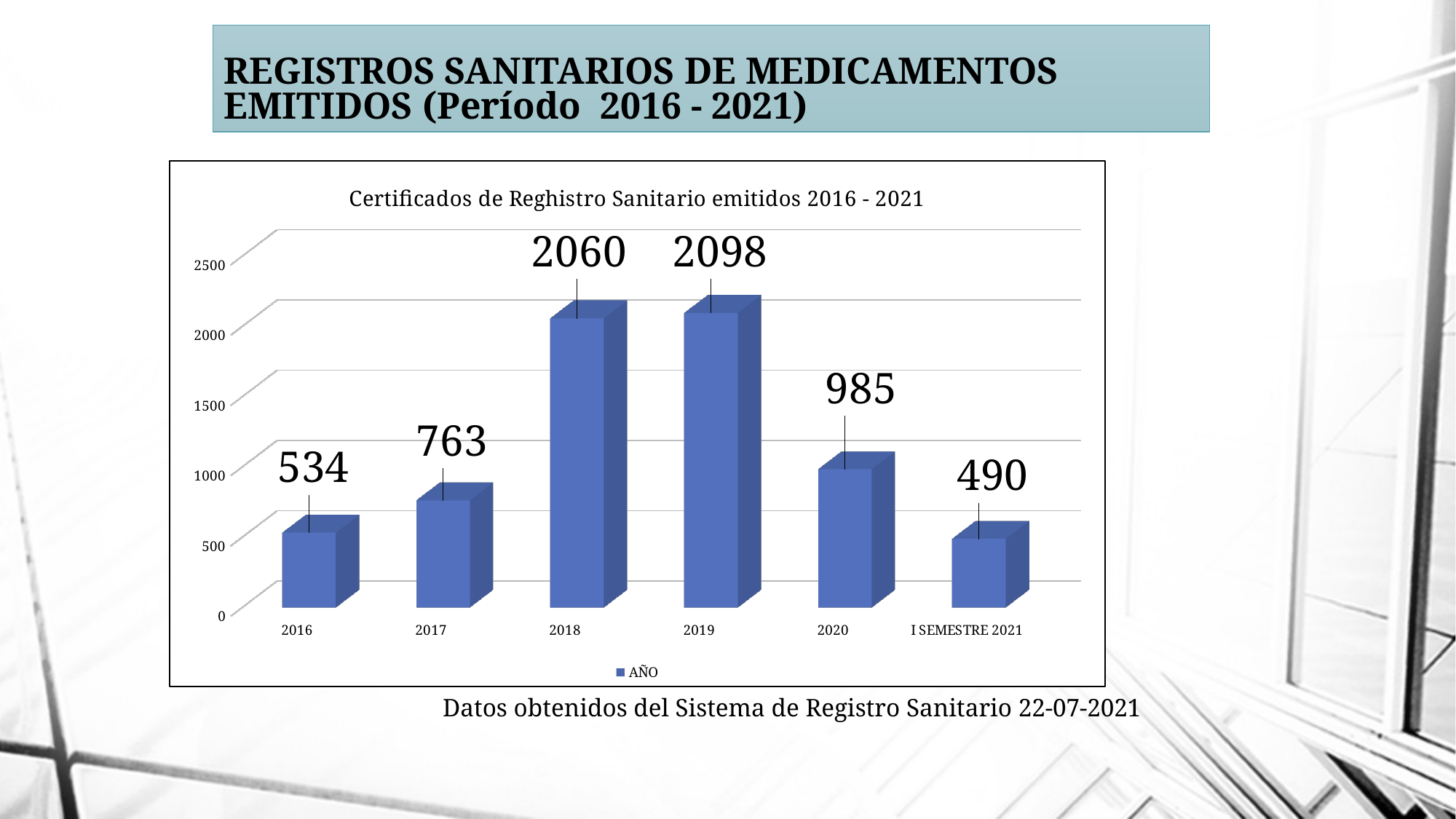
What is the value for 2018? 2060 What is the difference between the values for 2019 and 2018? 38 How many categories are shown on the x axis? 6 What is the difference between the values for 2017 and 2016? 229 What kind of chart is shown? bar chart Which category has the lowest value? I SEMESTRE 2021 What is the value for 2020? 985 Which category has the highest value? 2019 Which is larger, the value for 2020 or the value for 2017? 2020 What is the value for I SEMESTRE 2021? 490 What is the title of the chart? Certificados de Reghistro Sanitario emitidos 2016 - 2021 How many series does the legend list? 1